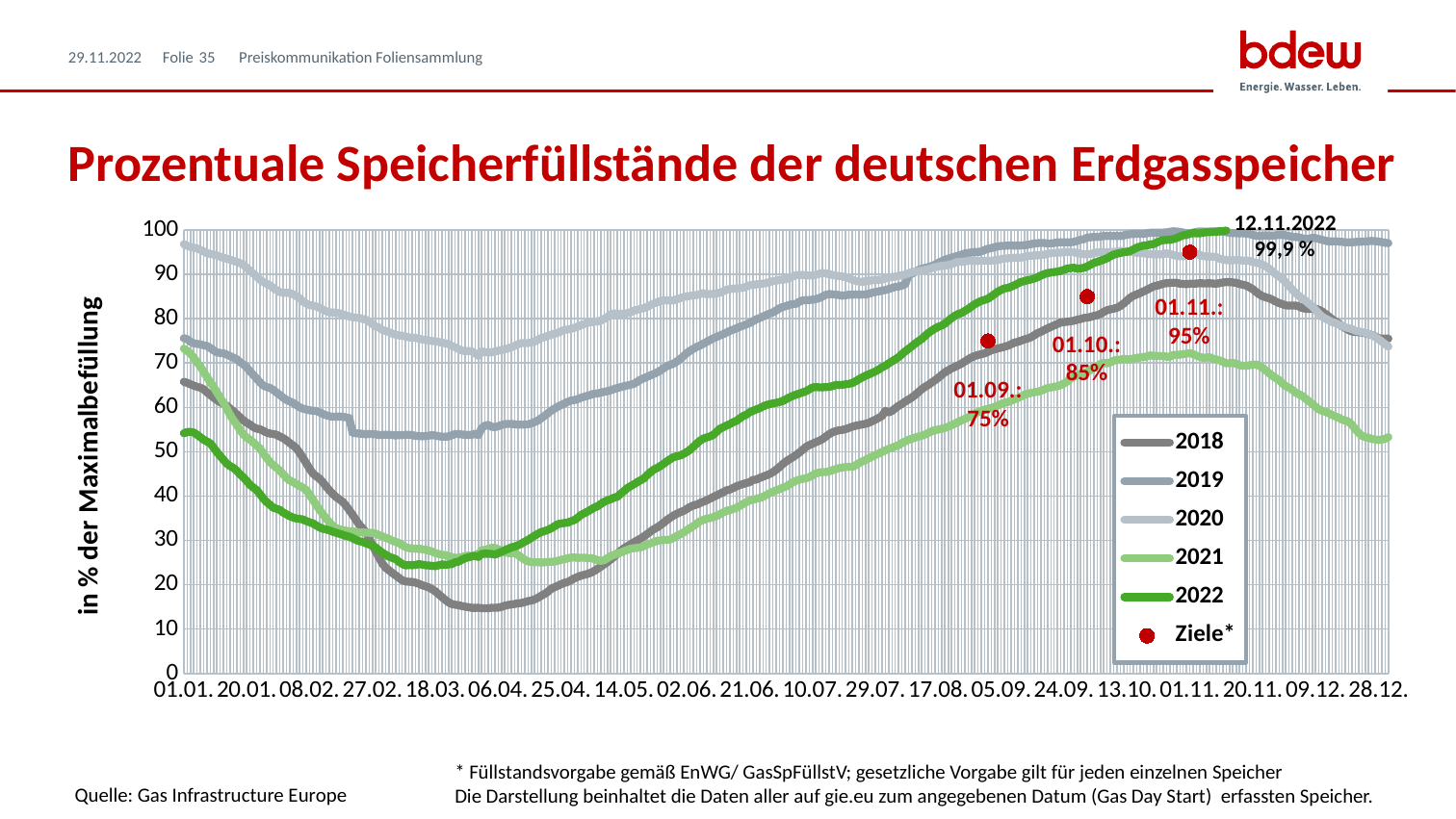
What kind of chart is shown on the slide? line chart Is the value of the 2022 line at 01.01. greater or less than 60? less What is the difference between the target for 01.11. and the target for 01.09.? 20% Is the value of the 2020 line at 01.01. greater or less than 90? greater Which series reaches the lowest value on the chart? 2018 What storage fill level is labelled for 12.11.2022? 99,9 % Does the 2022 line rise or fall between 06.04. and 12.11.? rise What is the target (Ziel) value labelled for 01.11.? 95% What is the target (Ziel) value labelled for 01.10.? 85% How many entries does the chart legend list? 6 At 01.01., which line is higher, 2020 or 2022? 2020 What is the target (Ziel) value labelled for 01.09.? 75%